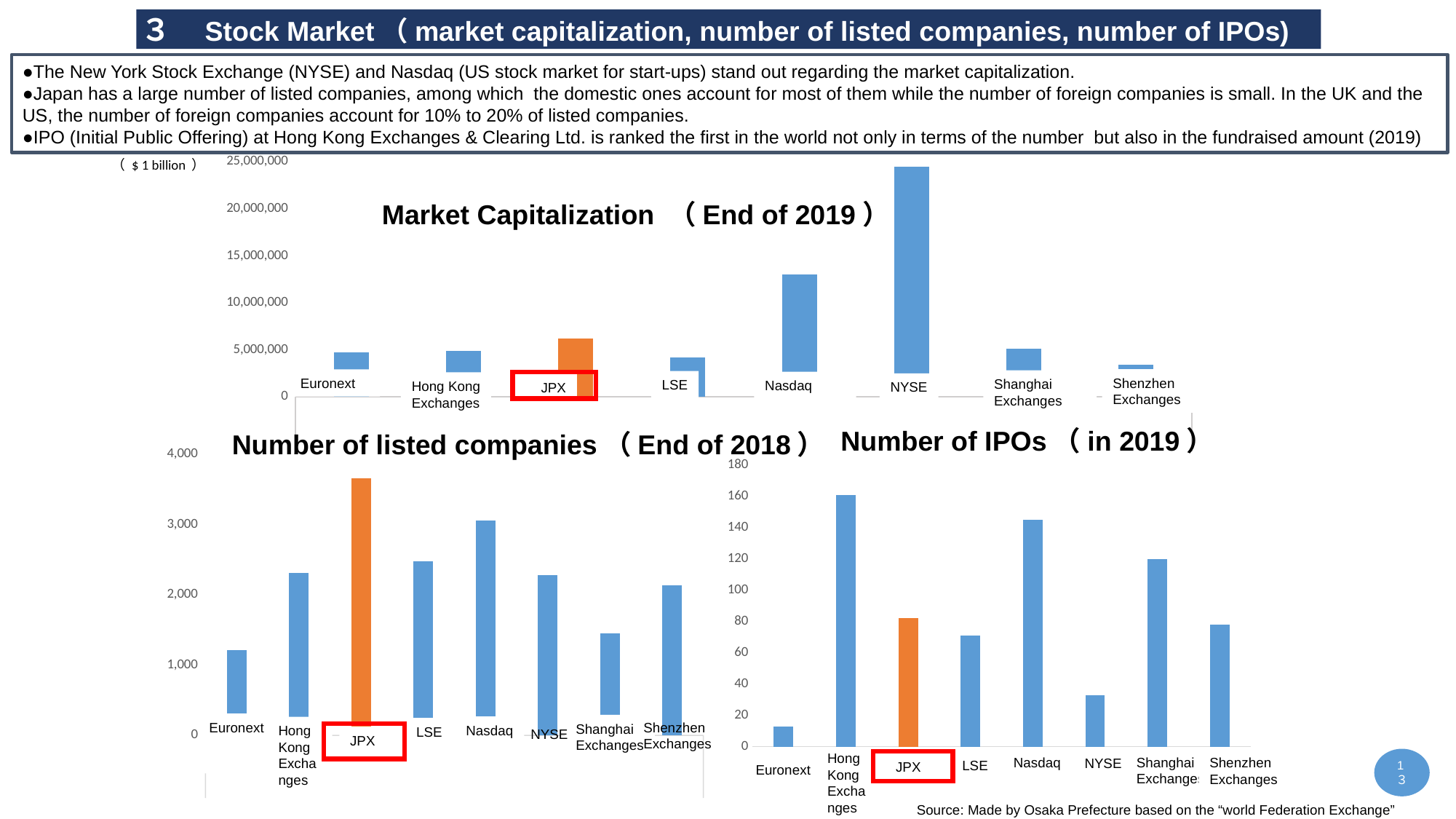
In the Market Capitalization (End of 2019) chart, is the value for Nasdaq greater or less than 10,000,000? greater How many exchanges are shown in the Number of IPOs (in 2019) chart? 8 In the Market Capitalization (End of 2019) chart, which exchange has the lowest market capitalization? Shenzhen Exchanges In the Market Capitalization (End of 2019) chart, is the value for NYSE greater or less than 20,000,000? greater In the Number of listed companies (End of 2018) chart, which exchange has the most listed companies? JPX In the Number of listed companies (End of 2018) chart, which exchange has the fewest listed companies? Euronext In the Number of IPOs (in 2019) chart, which has more IPOs, Nasdaq or Shanghai Exchanges? Nasdaq In the Number of listed companies (End of 2018) chart, is the value for JPX greater or less than 3,000? greater In the Number of IPOs (in 2019) chart, which exchange has the highest number of IPOs? Hong Kong Exchanges In the Number of listed companies (End of 2018) chart, which has more listed companies, LSE or Shanghai Exchanges? LSE In the Market Capitalization (End of 2019) chart, which exchange has the highest market capitalization? NYSE